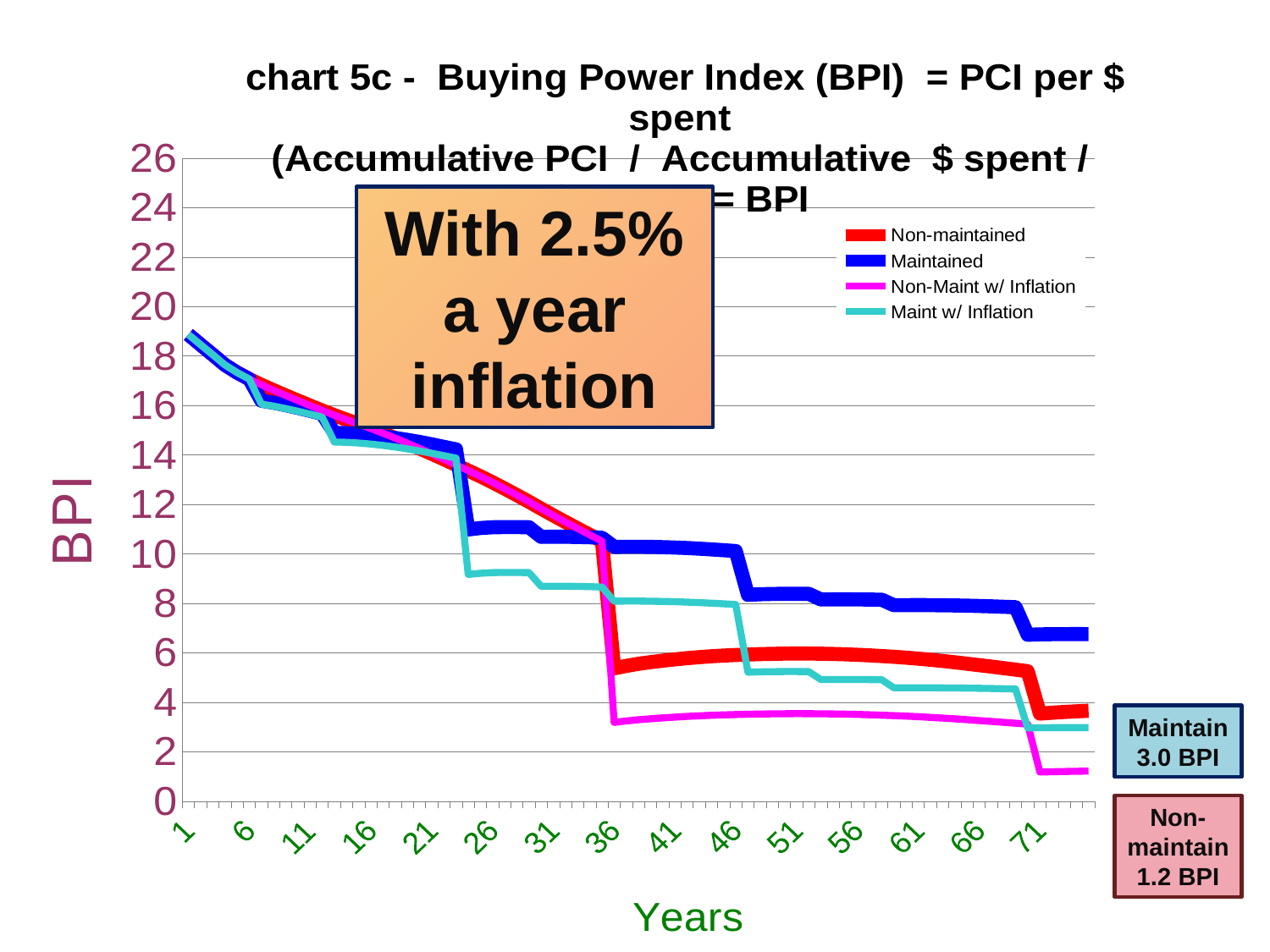
Do the BPI values rise or fall as the years increase along the x axis? fall Is the value for the Maint w/ Inflation series at year 41 greater or less than 10? less What annual inflation rate does the text box on the chart say is assumed? 2.5% Is the value for the Non-Maint w/ Inflation series at year 71 greater or less than 2? less How many series does the legend list? 4 Which series has the lowest BPI at the right end of the chart? Non-Maint w/ Inflation Is the value for the Non-maintained series at year 51 greater or less than 4? greater What kind of chart is shown on the slide? line chart Which series has the highest BPI at the right end of the chart? Maintained At year 56, which is larger: the Maintained series or the Non-maintained series? Maintained What are the four series listed in the legend? Non-maintained, Maintained, Non-Maint w/ Inflation, Maint w/ Inflation